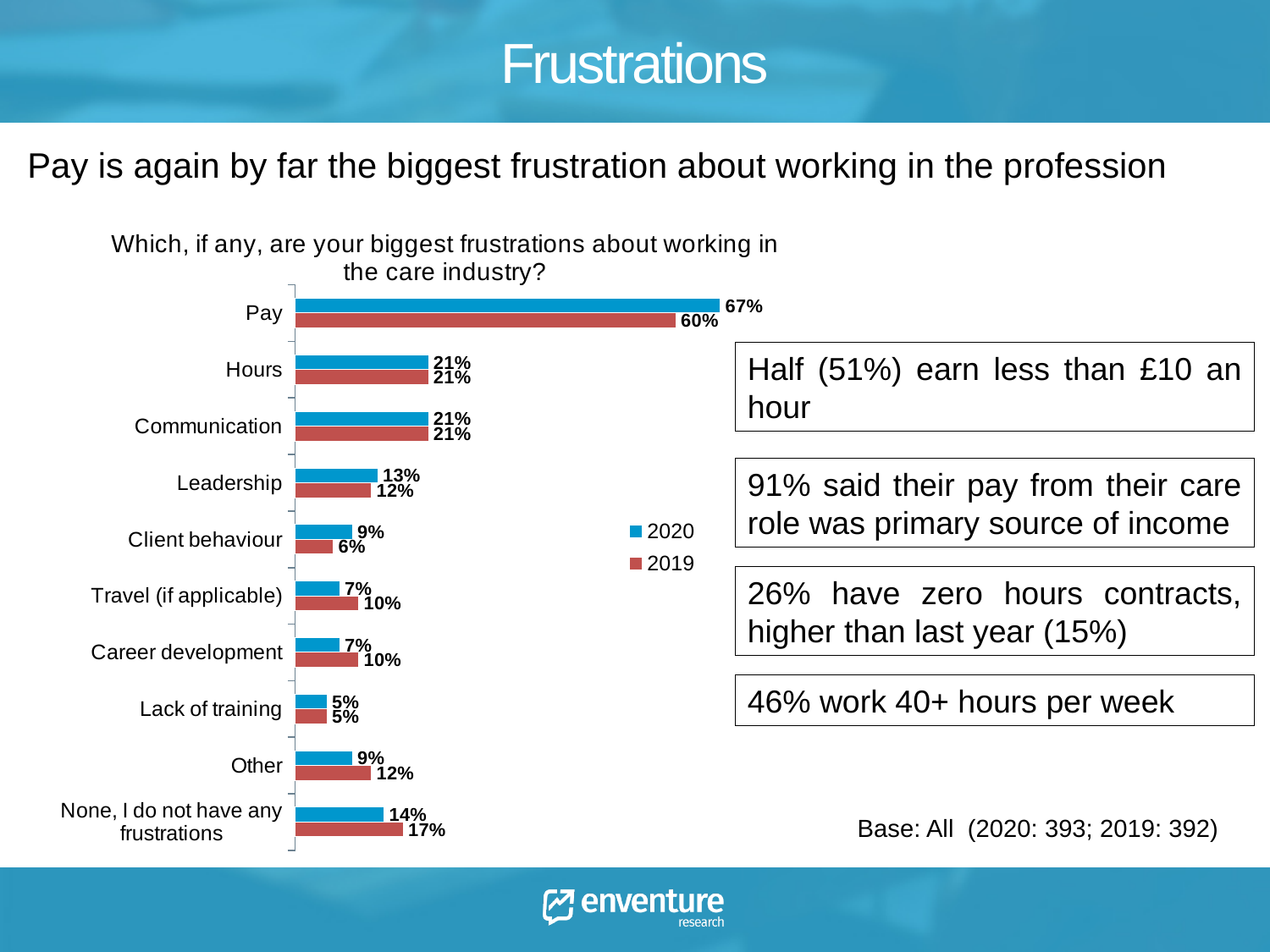
Which series does the blue colour represent in the legend? 2020 What is the 2019 value for Travel (if applicable)? 10% What is the difference between the 2020 and 2019 values for Pay? 7% How many series does the legend list? 2 What kind of chart is shown on the slide? Bar chart Which category has the highest 2020 value? Pay What is the 2019 value for None, I do not have any frustrations? 17% What is the 2020 value for Client behaviour? 9% Which is larger for Other: the 2020 value or the 2019 value? 2019 What is the 2020 value for Pay? 67% How many categories are shown on the chart? 10 Which category has the lowest 2019 value? Lack of training